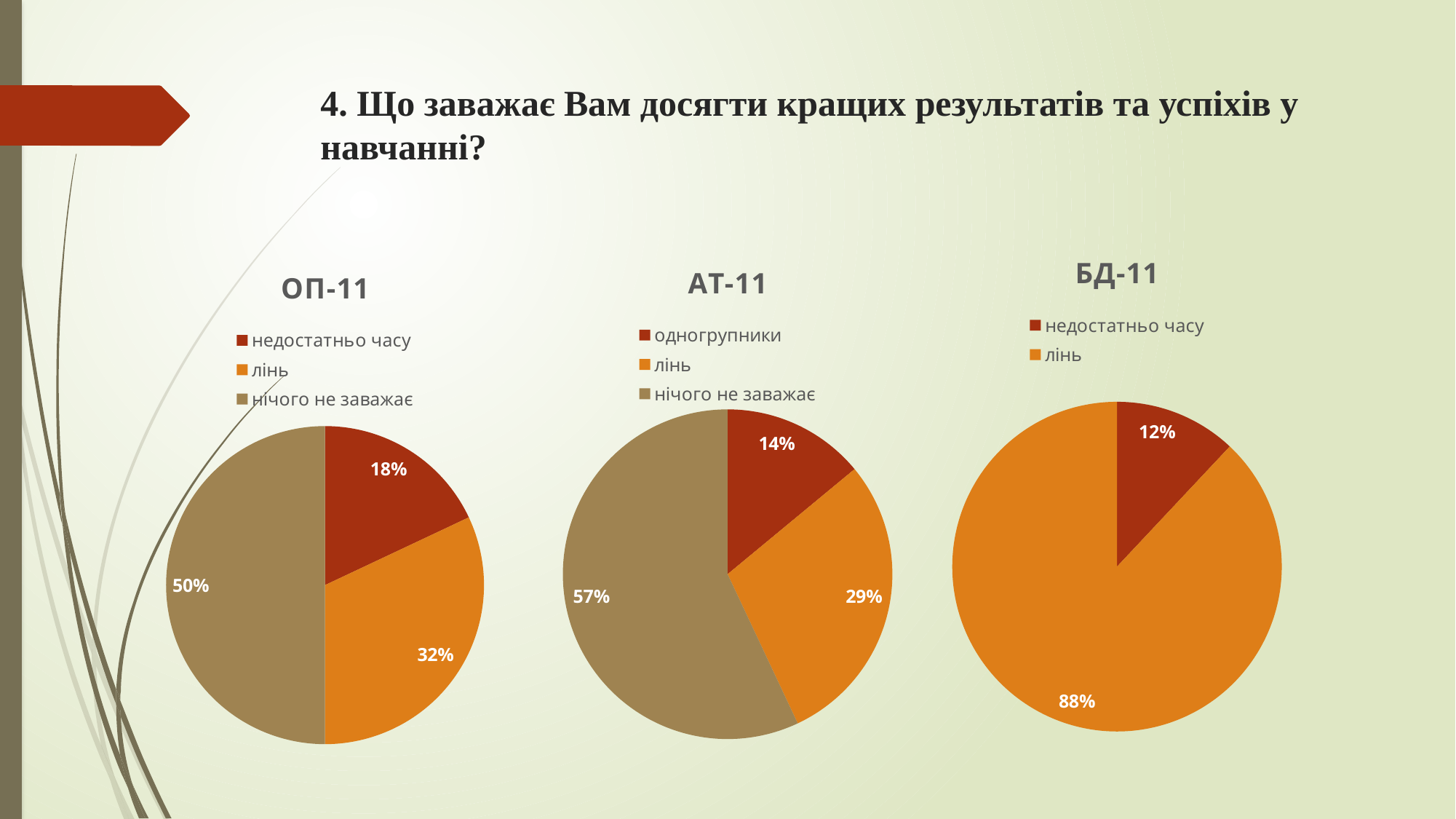
In the ОП-11 chart, which is larger: the 'лінь' slice or the 'недостатньо часу' slice? лінь How many pie charts are shown on the slide? 3 In the АТ-11 chart, what share is labelled for 'одногрупники'? 14% In the ОП-11 chart, what share is labelled for 'недостатньо часу'? 18% In the ОП-11 chart, what share is labelled for 'лінь'? 32% In the ОП-11 chart, which category has the largest slice? нічого не заважає In the АТ-11 chart, what share is labelled for 'нічого не заважає'? 57% What kind of chart is the ОП-11 chart? pie chart In the АТ-11 chart, which category has the smallest slice? одногрупники In the БД-11 chart, what share is labelled for 'лінь'? 88% In the БД-11 chart, how many categories does the legend list? 2 In the АТ-11 chart, what is the difference between the 'лінь' and 'одногрупники' shares? 15%